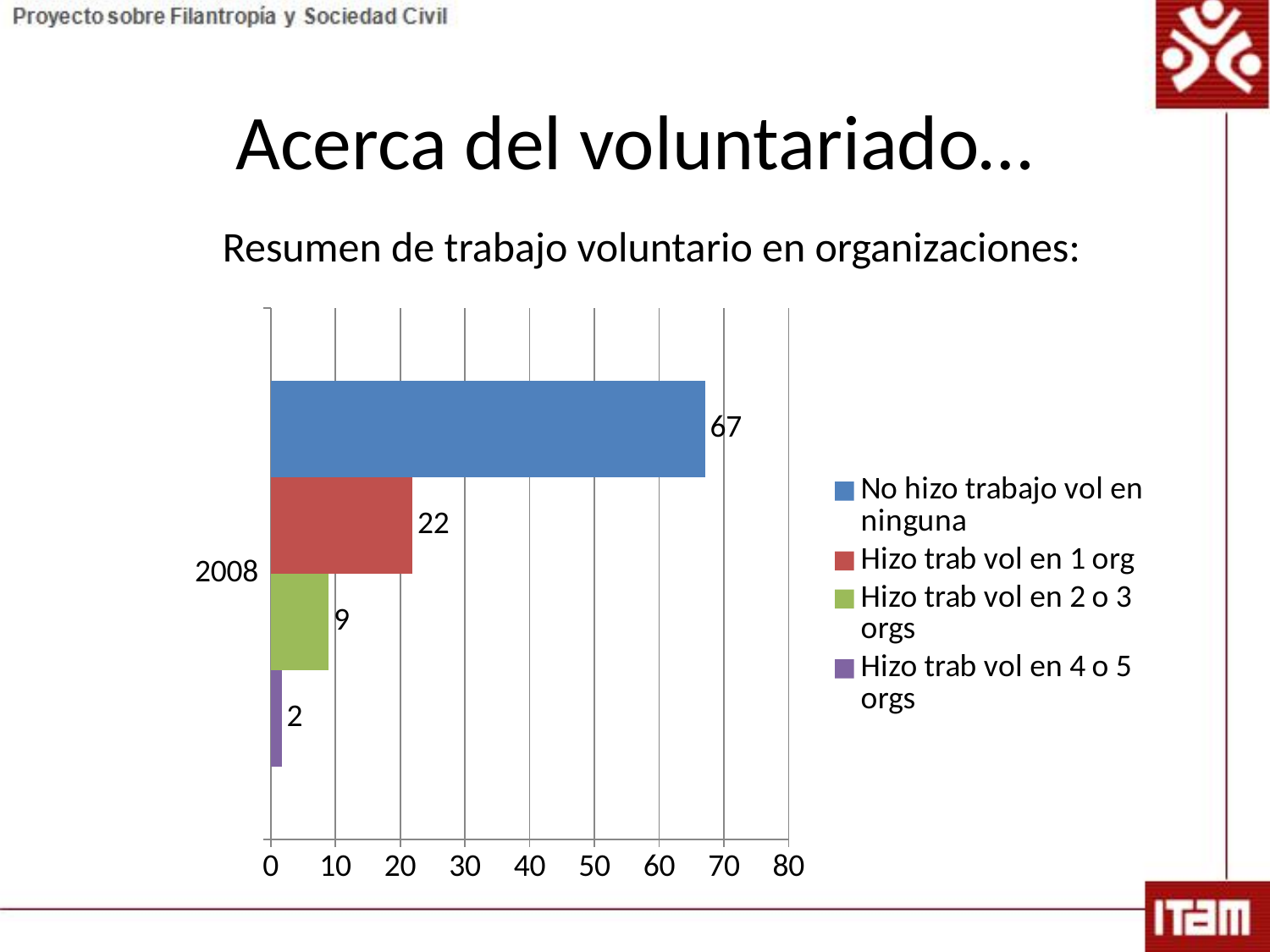
What is the value for "Hizo trab vol en 4 o 5 orgs" in 2008? 2 What is the value for "No hizo trabajo vol en ninguna" in 2008? 67 How many series does the legend list? 4 Is the value for "No hizo trabajo vol en ninguna" greater or less than 60? greater Which is larger, the value for "Hizo trab vol en 1 org" or "Hizo trab vol en 2 o 3 orgs"? Hizo trab vol en 1 org Which series has the lowest value? Hizo trab vol en 4 o 5 orgs What year is labelled on the category axis of the chart? 2008 What is the difference between the values for "No hizo trabajo vol en ninguna" and "Hizo trab vol en 1 org"? 45 Which series has the highest value? No hizo trabajo vol en ninguna What kind of chart is shown on the slide? bar chart What is the value for "Hizo trab vol en 1 org" in 2008? 22 What is the value for "Hizo trab vol en 2 o 3 orgs" in 2008? 9